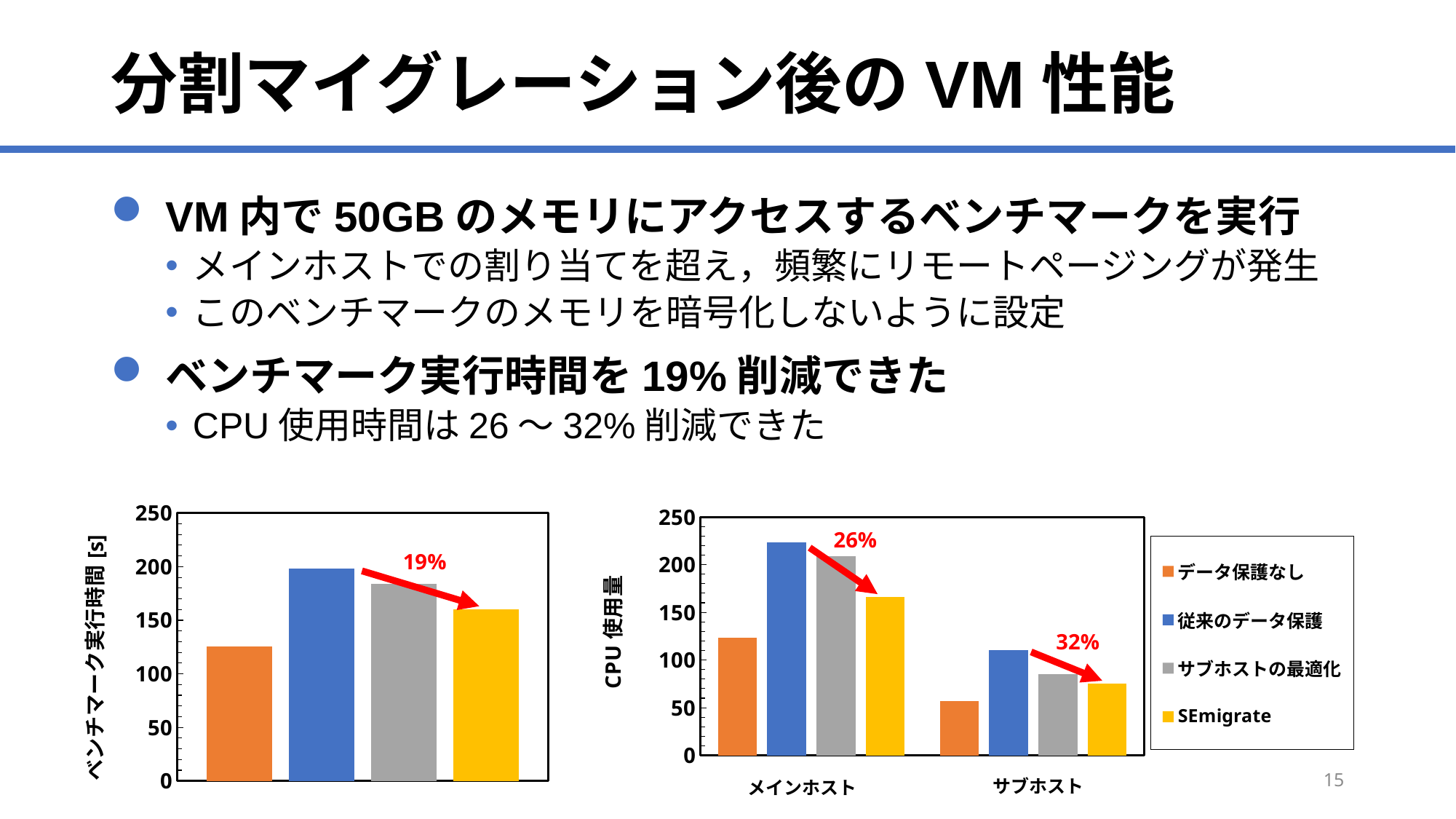
In the left chart (ベンチマーク実行時間 [s]), which series has the lowest bar? データ保護なし In the right chart (CPU 使用量), is the value for 従来のデータ保護 at メインホスト greater or less than 200? greater How many series does the legend list? 4 In the right chart (CPU 使用量), how many categories are shown on the x axis? 2 In the left chart (ベンチマーク実行時間 [s]), is the value for データ保護なし greater or less than 150? less What percentage reduction is annotated with the red arrow in the left chart (ベンチマーク実行時間 [s])? 19% In the left chart (ベンチマーク実行時間 [s]), which series has the highest bar? 従来のデータ保護 What kind of chart is the left chart (ベンチマーク実行時間 [s])? bar chart In the right chart (CPU 使用量), is the SEmigrate bar larger for メインホスト or for サブホスト? メインホスト In the left chart (ベンチマーク実行時間 [s]), is the value for 従来のデータ保護 greater or less than 150? greater In the right chart (CPU 使用量), which series has the highest bar for メインホスト? 従来のデータ保護